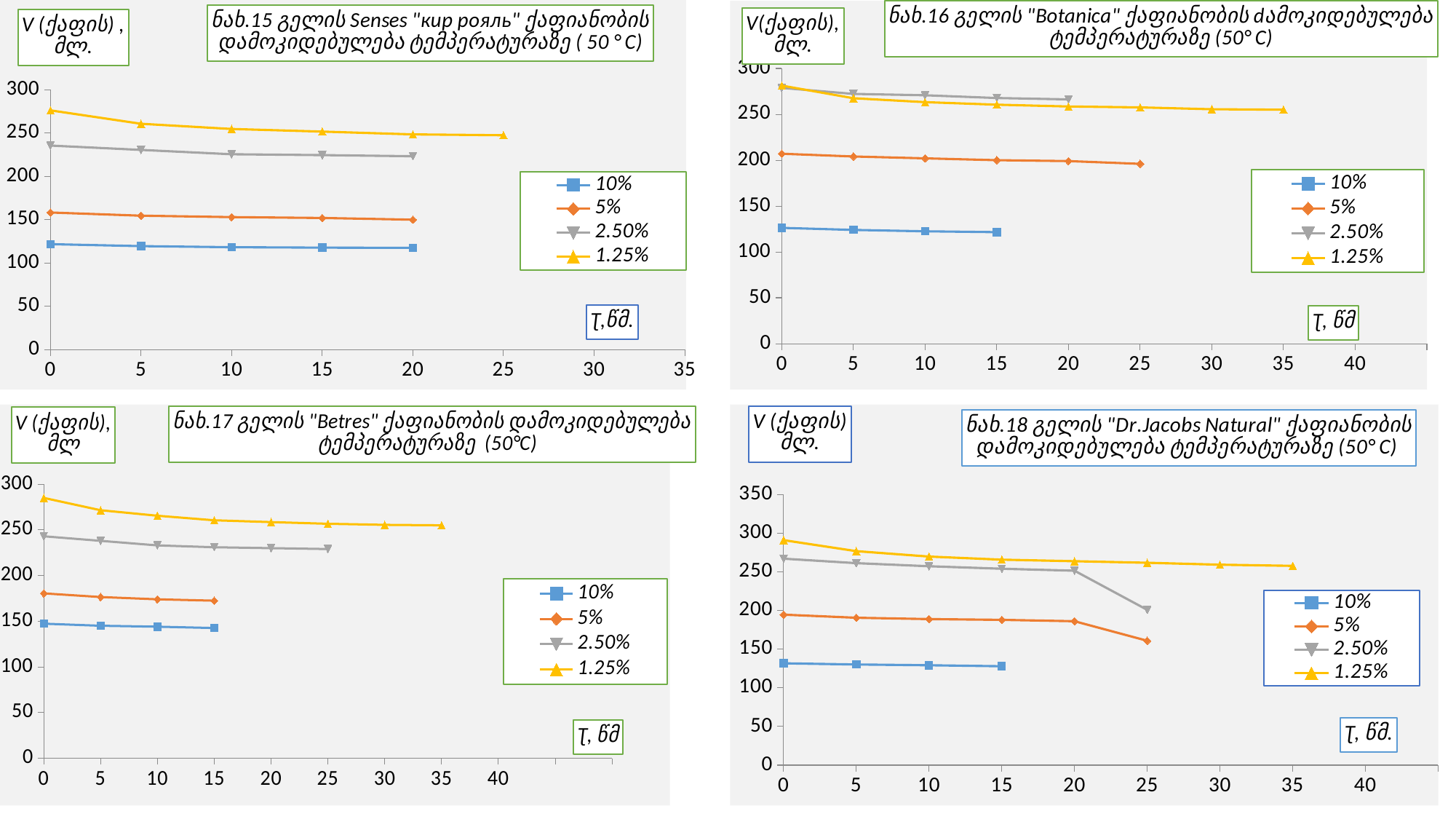
How many series does the legend list on the top-right chart (Botanica)? 4 On the bottom-right chart (Dr.Jacobs Natural), at time 25, which series has the larger value: 1.25% or 5%? 1.25% On the bottom-right chart (Dr.Jacobs Natural), which series has the lowest values? 10% On the top-left chart (Senses "кир рояль"), which series has the highest values? 1.25% How many data points does the 10% series have on the top-right chart (Botanica)? 4 On the bottom-right chart (Dr.Jacobs Natural), do the values of the 2.50% series rise or fall as time increases? fall On the top-left chart (Senses "кир рояль"), is the value of the 10% series at time 0 greater or less than 100? greater How many data points does the 1.25% series have on the bottom-left chart (Betres)? 8 What kind of chart is the top-left chart (Senses "кир рояль")? line chart On the bottom-left chart (Betres), is the value of the 5% series at time 0 greater or less than 200? less On the top-right chart (Botanica), is the value of the 2.50% series at time 0 greater or less than 250? greater